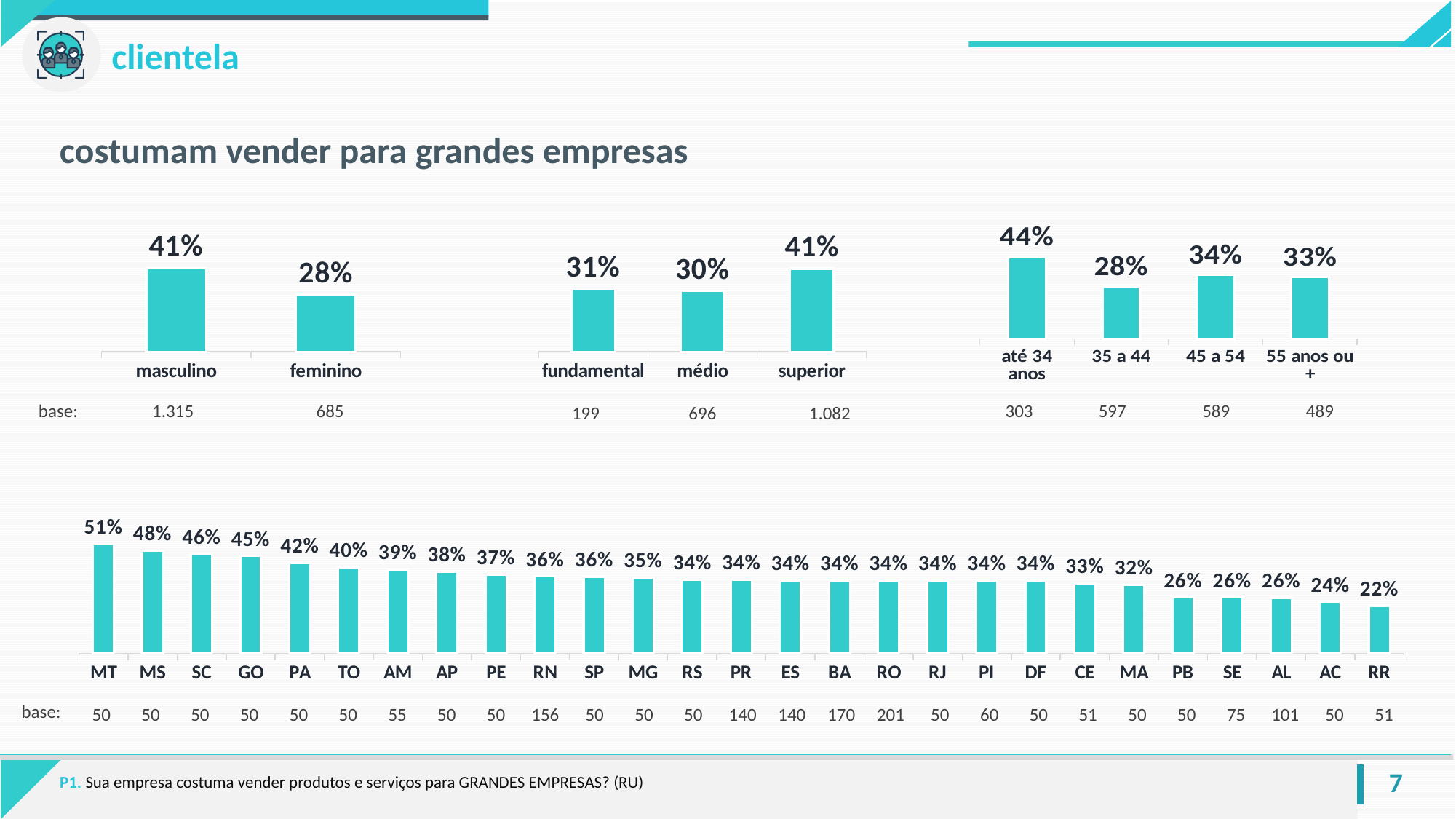
In the bottom chart by state, which state has the lowest value? RR In the top-left chart by gender, what is the difference between masculino and feminino? 13 percentage points In the top-middle chart by education level, which category has the highest value? superior In the top-right chart by age group, which category has the lowest value? 35 a 44 In the top-right chart by age group, what is the value for até 34 anos? 44% In the top-left chart by gender, what is the value for masculino? 41% In the bottom chart by state, how many states are shown? 27 In the bottom chart by state, which state has the highest value? MT In the bottom chart by state, what is the value for SP? 36% In the top-right chart by age group, how many age categories are shown? 4 In the top-middle chart by education level, what is the value for médio? 30% In the bottom chart by state, do the values rise or fall from left to right? fall